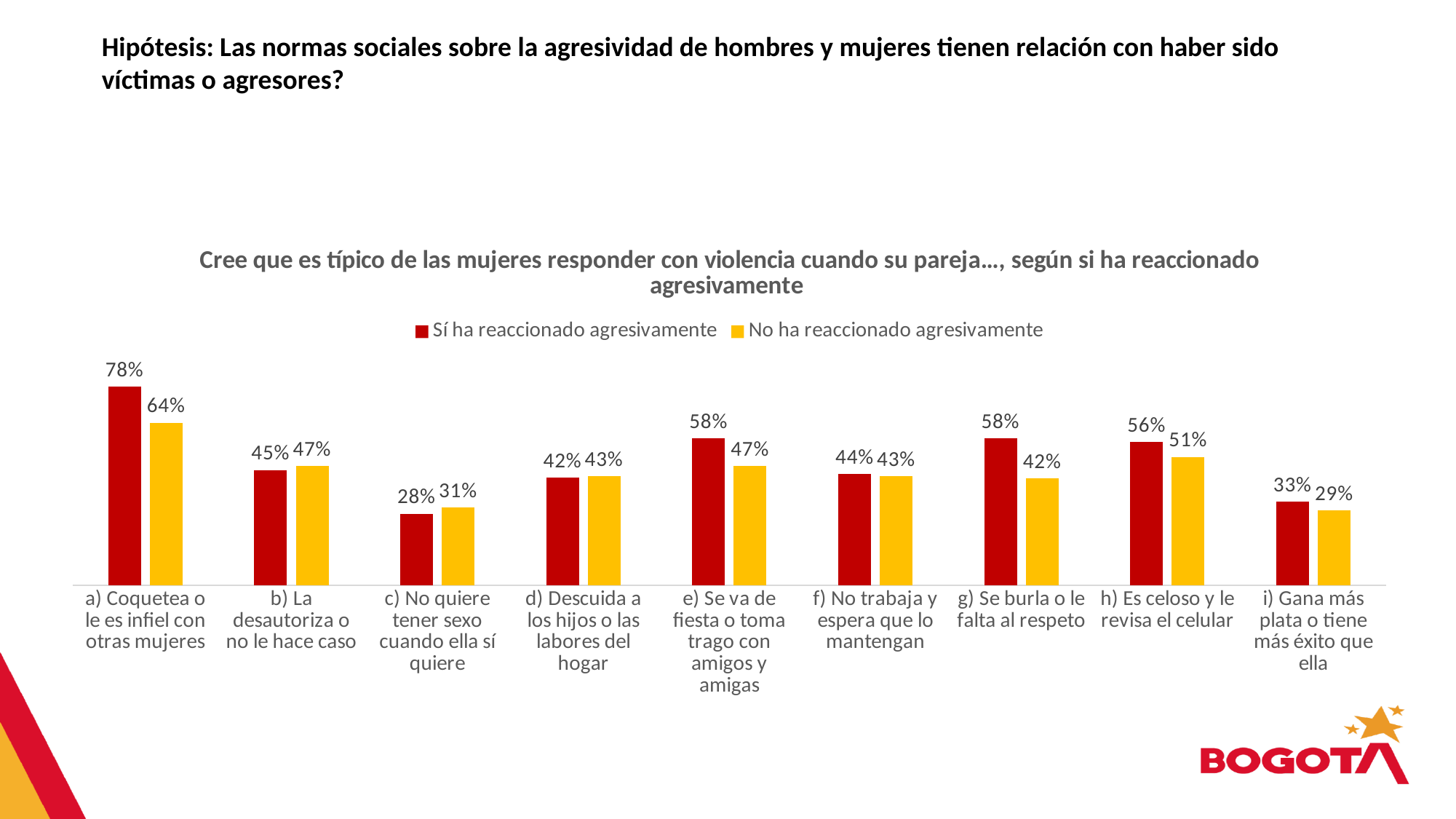
What is the value for 'Sí ha reaccionado agresivamente' in category 'a) Coquetea o le es infiel con otras mujeres'? 78% Which category has the highest value for 'Sí ha reaccionado agresivamente'? a) Coquetea o le es infiel con otras mujeres How many series does the legend list? 2 What is the difference between the two series in category 'g) Se burla o le falta al respeto'? 16% What is the difference between the two series in category 'a) Coquetea o le es infiel con otras mujeres'? 14% What kind of chart is shown on the slide? Bar chart How many categories are shown on the x axis? 9 What is the value for 'Sí ha reaccionado agresivamente' in category 'c) No quiere tener sexo cuando ella sí quiere'? 28% Which category has the lowest value for 'No ha reaccionado agresivamente'? i) Gana más plata o tiene más éxito que ella What is the value for 'No ha reaccionado agresivamente' in category 'h) Es celoso y le revisa el celular'? 51% What colour represents the series 'Sí ha reaccionado agresivamente'? Red In category 'c) No quiere tener sexo cuando ella sí quiere', which series has the larger value? No ha reaccionado agresivamente